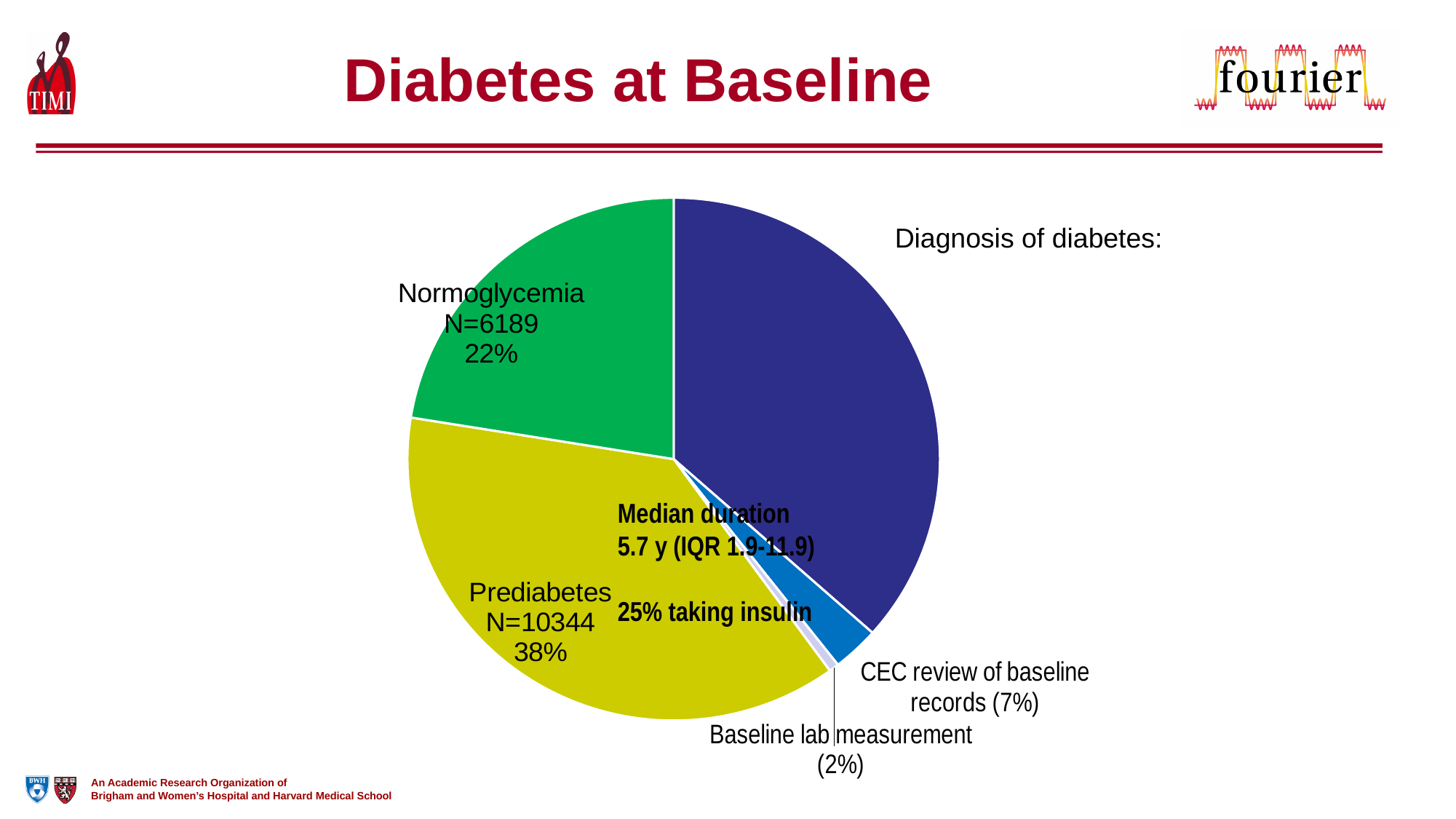
What percentage is labelled for diabetes diagnosed by baseline lab measurement? 2% Which slice is larger, Prediabetes or Normoglycemia? Prediabetes Which labelled slice has the smallest percentage? Baseline lab measurement (2%) What percentage of the pie is the Prediabetes slice? 38% What is the N for the Normoglycemia slice? N=6189 What kind of chart is shown on the slide? pie chart What is the N for the Prediabetes slice? N=10344 According to the text on the chart, what percentage of patients with diabetes were taking insulin? 25% What is the title of the slide containing the pie chart? Diabetes at Baseline What percentage is labelled for diabetes diagnosed by CEC review of baseline records? 7% What percentage of the pie is the Normoglycemia slice? 22% By how many percentage points does the Prediabetes share exceed the Normoglycemia share? 16 percentage points